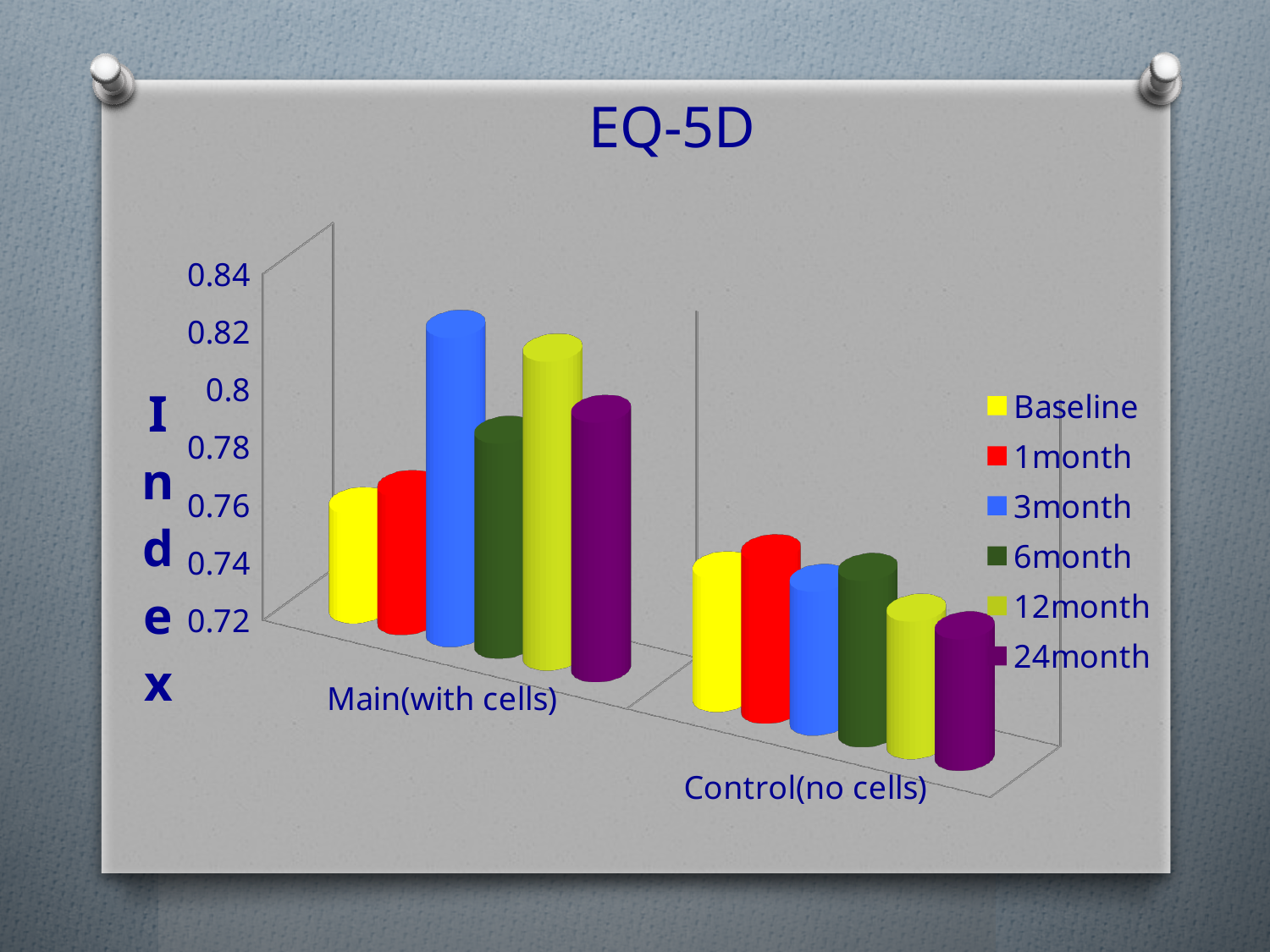
Is the Baseline value for Main(with cells) greater or less than 0.8? less Is the 3month value for Main(with cells) greater or less than 0.8? greater How many categories are shown on the x axis? 2 What kind of chart is shown on the slide? bar chart Which is larger: the 3month value for Main(with cells) or the 3month value for Control(no cells)? Main(with cells) What label is shown on the vertical axis? Index How many series does the legend list? 6 What is the title of the chart? EQ-5D